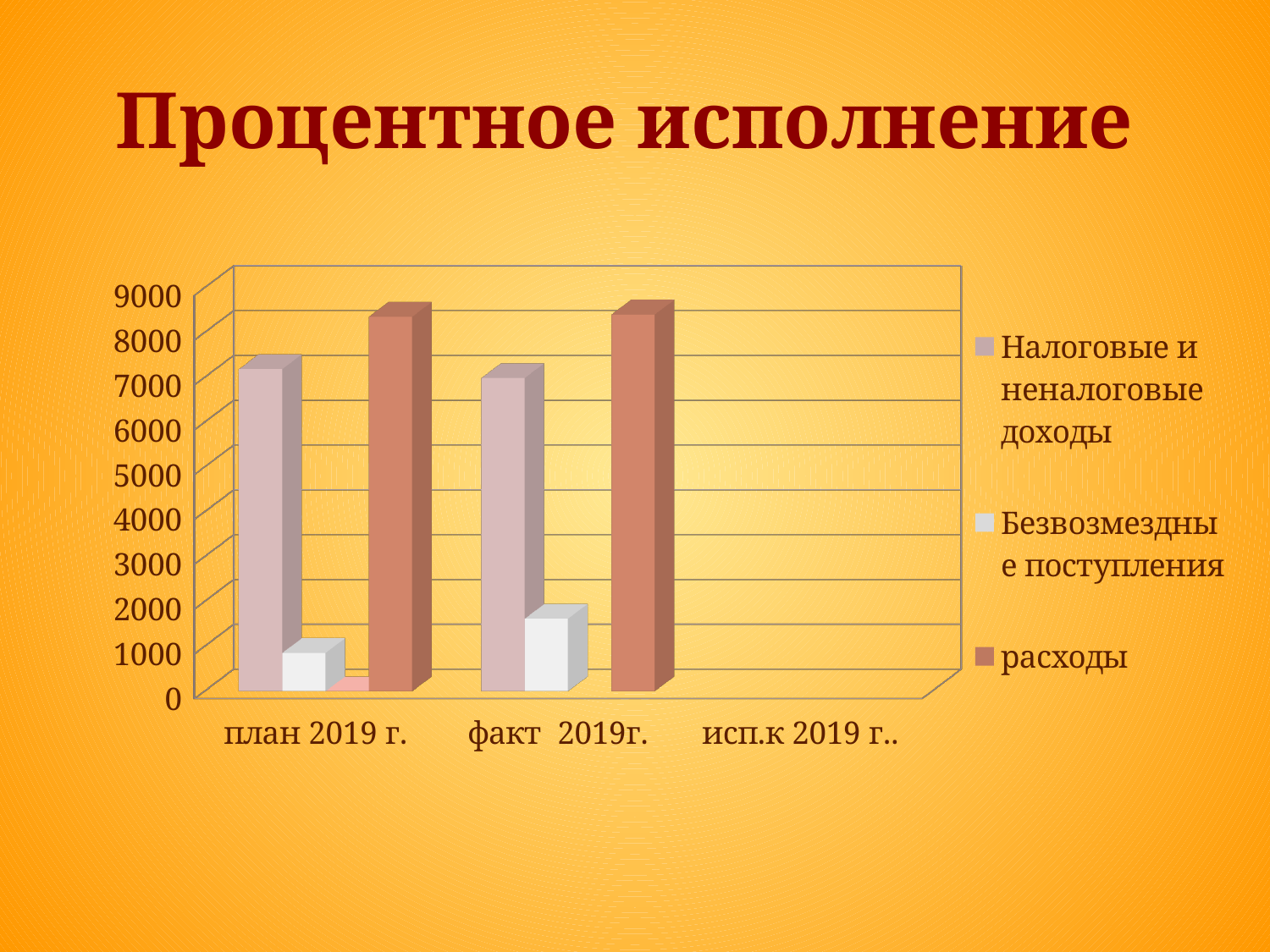
What kind of chart is shown on the slide? bar chart How many series does the legend list? 3 Which is larger for 'Безвозмездные поступления': 'план 2019 г.' or 'факт 2019г.'? факт 2019г. Is the value for 'Безвозмездные поступления' in 'план 2019 г.' greater or less than 2000? less Is the value for 'Налоговые и неналоговые доходы' in 'план 2019 г.' greater or less than 6000? greater What is the title of the chart? Процентное исполнение Which series has the highest value in the 'план 2019 г.' category? расходы Is the value for 'Безвозмездные поступления' in 'факт 2019г.' greater or less than 3000? less How many categories are shown on the x axis? 3 Which series has the lowest value in the 'факт 2019г.' category? Безвозмездные поступления Which is larger in 'план 2019 г.': 'расходы' or 'Налоговые и неналоговые доходы'? расходы